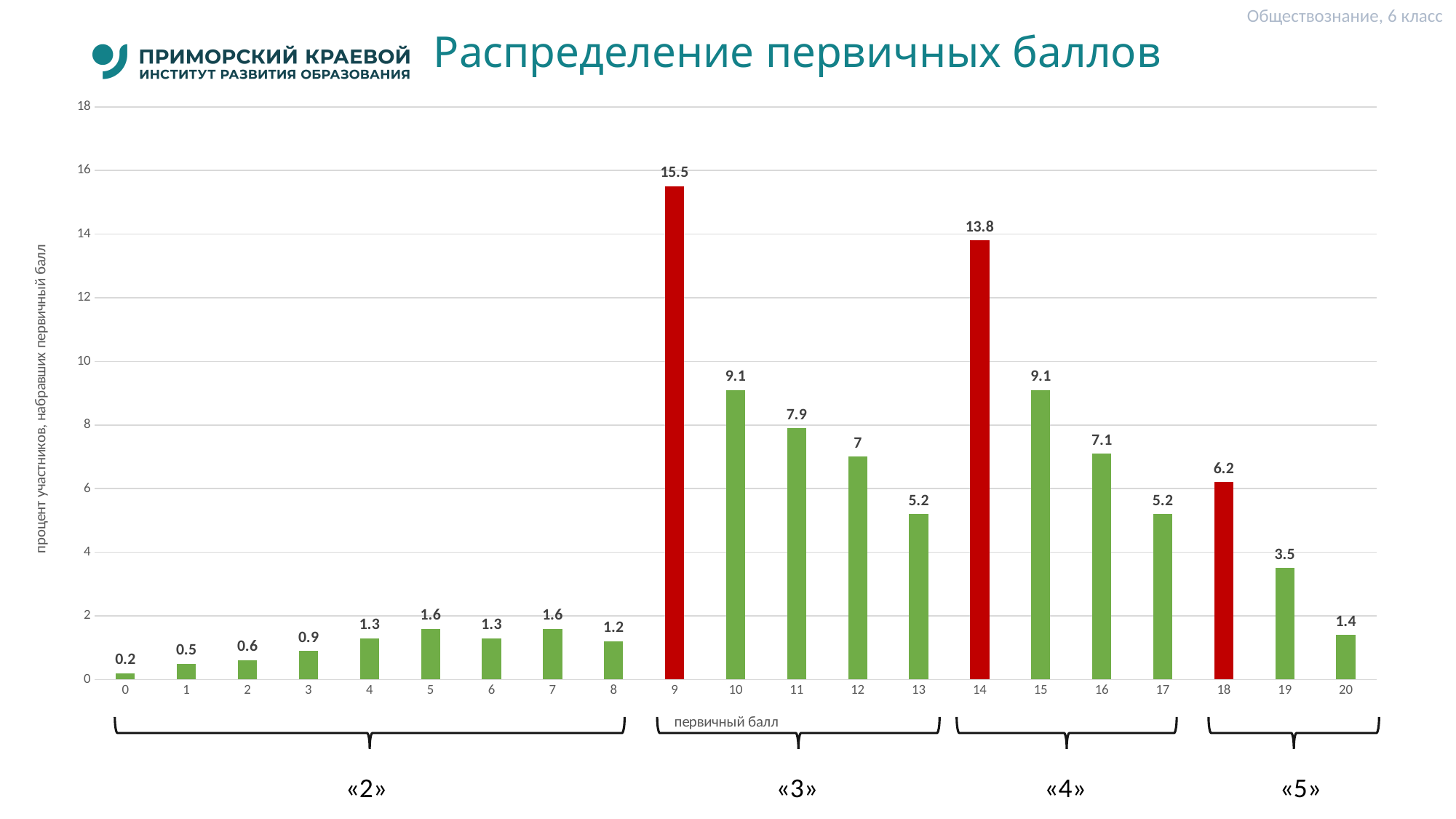
How many primary score categories are shown on the x axis? 21 Which primary score has the highest percentage of participants? 9 What is the value shown for a primary score of 14? 13.8 What type of chart is shown on the slide? Bar chart What percentage of participants scored 9 primary points? 15.5 Which is larger: the value for primary score 11 or for primary score 16? 11 What is the value shown for a primary score of 0? 0.2 Do the values rise or fall from primary score 14 to primary score 17? Fall Which primary score has the lowest percentage of participants? 0 What is the value shown for a primary score of 18? 6.2 What is the difference between the values for primary scores 9 and 14? 1.7 What is the title of the chart? Распределение первичных баллов